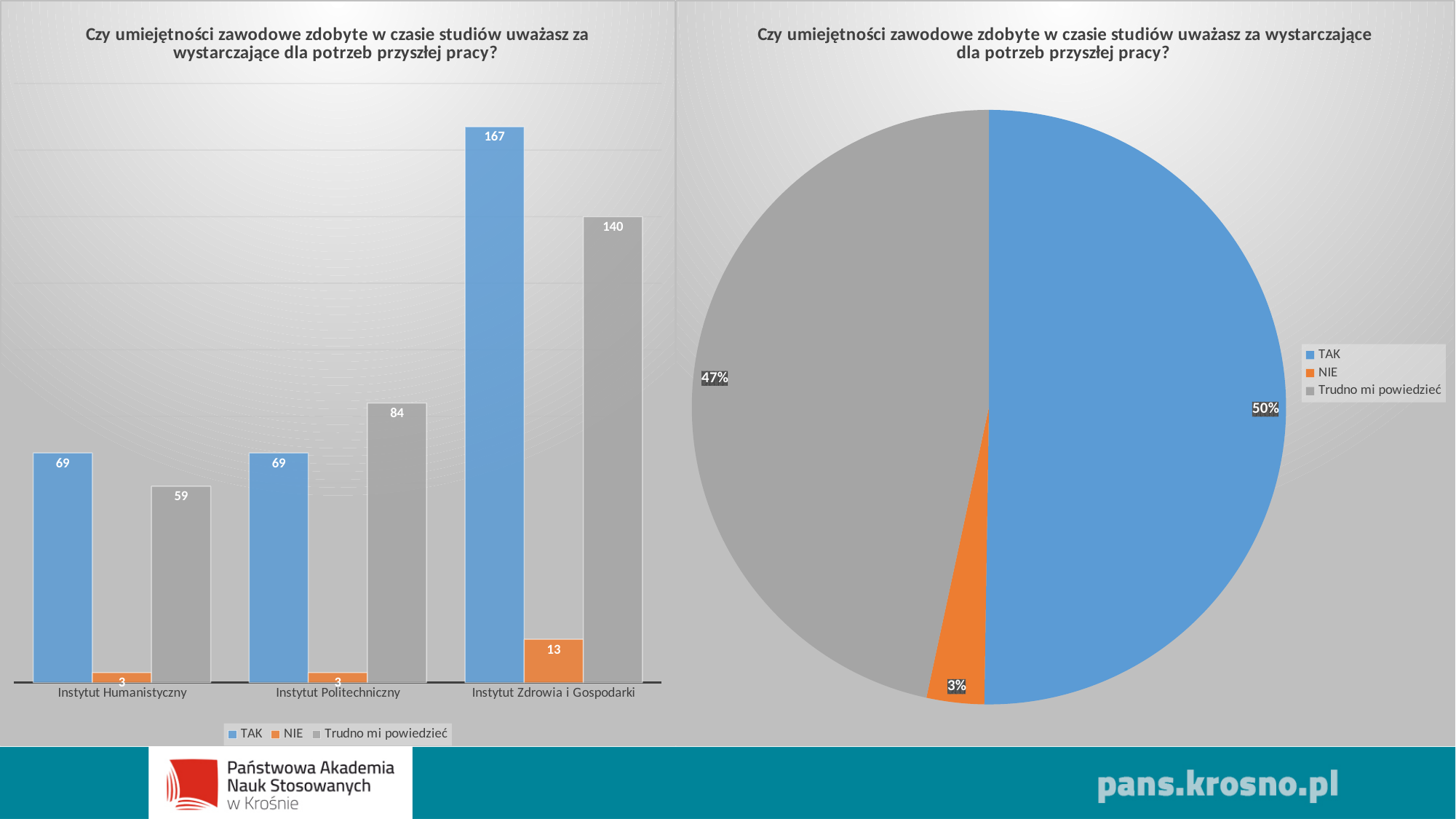
In the pie chart on the right, which answer has the smallest share? NIE In the bar chart on the left, which is larger for Instytut Politechniczny: TAK or Trudno mi powiedzieć? Trudno mi powiedzieć In the bar chart on the left, what is the value of Trudno mi powiedzieć for Instytut Politechniczny? 84 In the bar chart on the left, which institute has the highest TAK value? Instytut Zdrowia i Gospodarki What type of chart is shown on the right side of the slide? Pie chart In the bar chart on the left, what is the difference between TAK and Trudno mi powiedzieć for Instytut Zdrowia i Gospodarki? 27 In the pie chart on the right, what share does TAK have? 50% How many institutes are shown on the x axis of the bar chart on the left? 3 How many series does the legend of the bar chart on the left list? 3 In the bar chart on the left, what is the value of TAK for Instytut Zdrowia i Gospodarki? 167 In the bar chart on the left, what is the value of NIE for Instytut Humanistyczny? 3 In the bar chart on the left, which institute has the lowest Trudno mi powiedzieć value? Instytut Humanistyczny